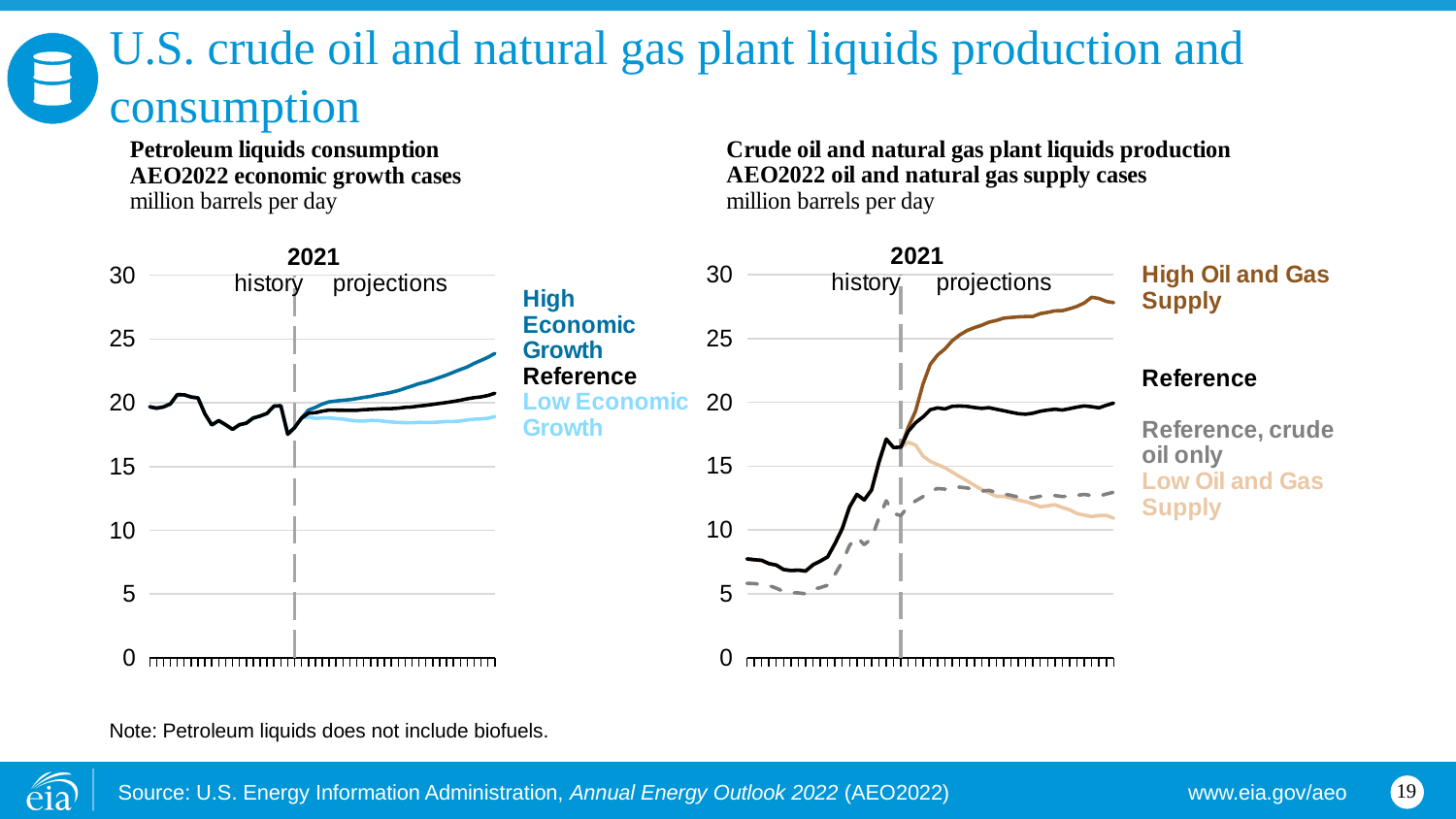
In the left chart, 'Petroleum liquids consumption', is the value for High Economic Growth at the end of the projection period greater or less than 20? greater How many series does the legend of the right chart, 'Crude oil and natural gas plant liquids production', list? 4 In the right chart, 'Crude oil and natural gas plant liquids production', which series is higher at the end of the projection period: High Oil and Gas Supply or Low Oil and Gas Supply? High Oil and Gas Supply In the right chart, 'Crude oil and natural gas plant liquids production', is the value for Low Oil and Gas Supply at the end of the projection period greater or less than 15? less What unit is used on the y axis of both charts? million barrels per day In the right chart, 'Crude oil and natural gas plant liquids production', is the value for Reference, crude oil only at the end of the projection period greater or less than 15? less What type of chart is the left chart, 'Petroleum liquids consumption'? line chart In the left chart, 'Petroleum liquids consumption', does the High Economic Growth series rise or fall over the projection period? rise In the right chart, 'Crude oil and natural gas plant liquids production', does the Low Oil and Gas Supply series rise or fall over the projection period? fall How many series does the legend of the left chart, 'Petroleum liquids consumption', list? 3